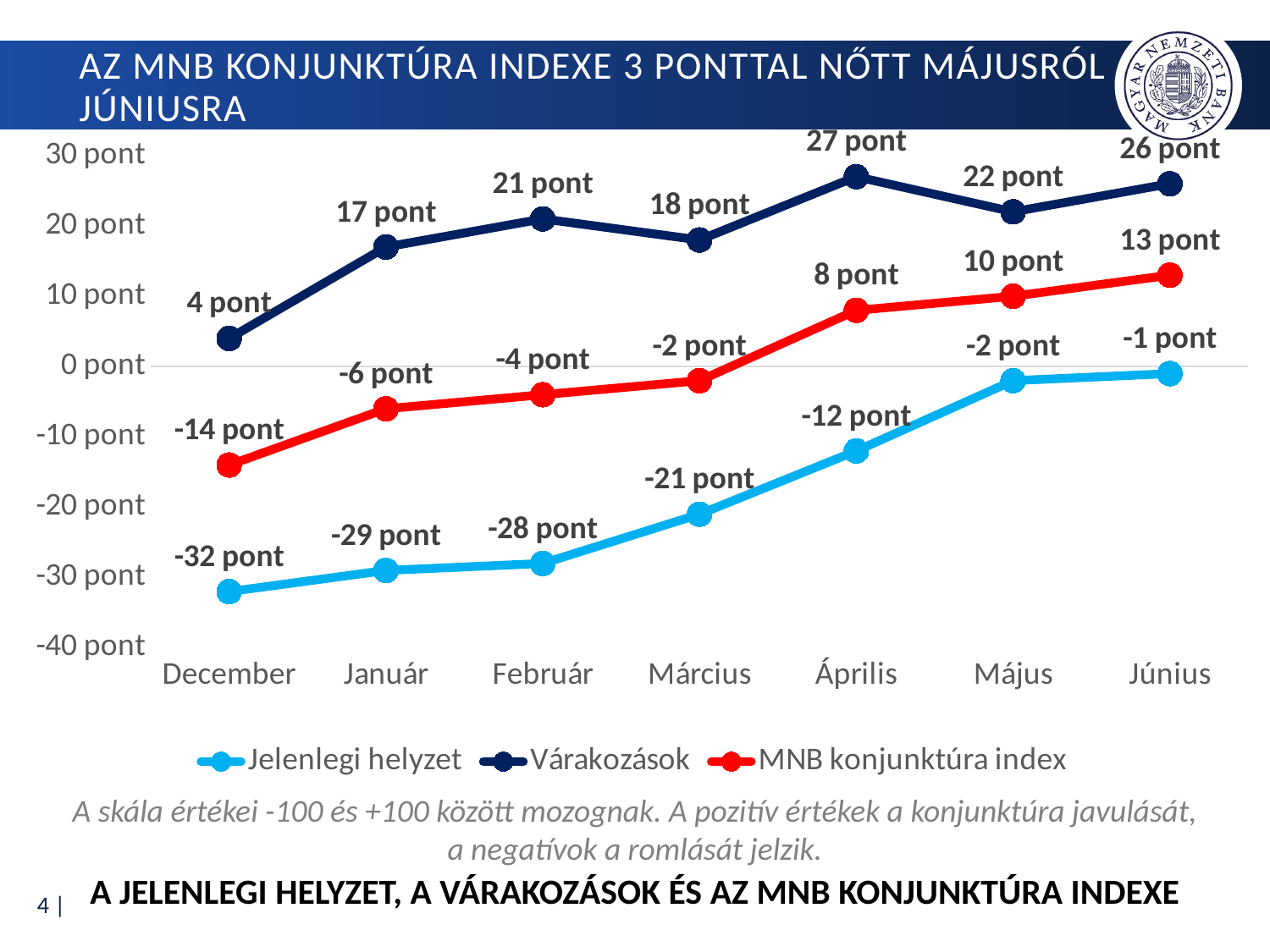
By how much did the MNB konjunktúra index change from Május to Június? 3 pont What is the value of the MNB konjunktúra index in Június? 13 pont In which month is the Várakozások series at its highest? Április How many months are plotted along the x axis? 7 What kind of chart is shown on the slide? line chart How many series does the legend list? 3 What is the value of Jelenlegi helyzet in December? -32 pont In which month is the Jelenlegi helyzet series at its lowest? December What is the value of Várakozások in Március? 18 pont Does the Jelenlegi helyzet series generally rise or fall from December to Június? rise Which is higher in Január: Várakozások or the MNB konjunktúra index? Várakozások What is the difference between Várakozások and Jelenlegi helyzet in Április? 39 pont